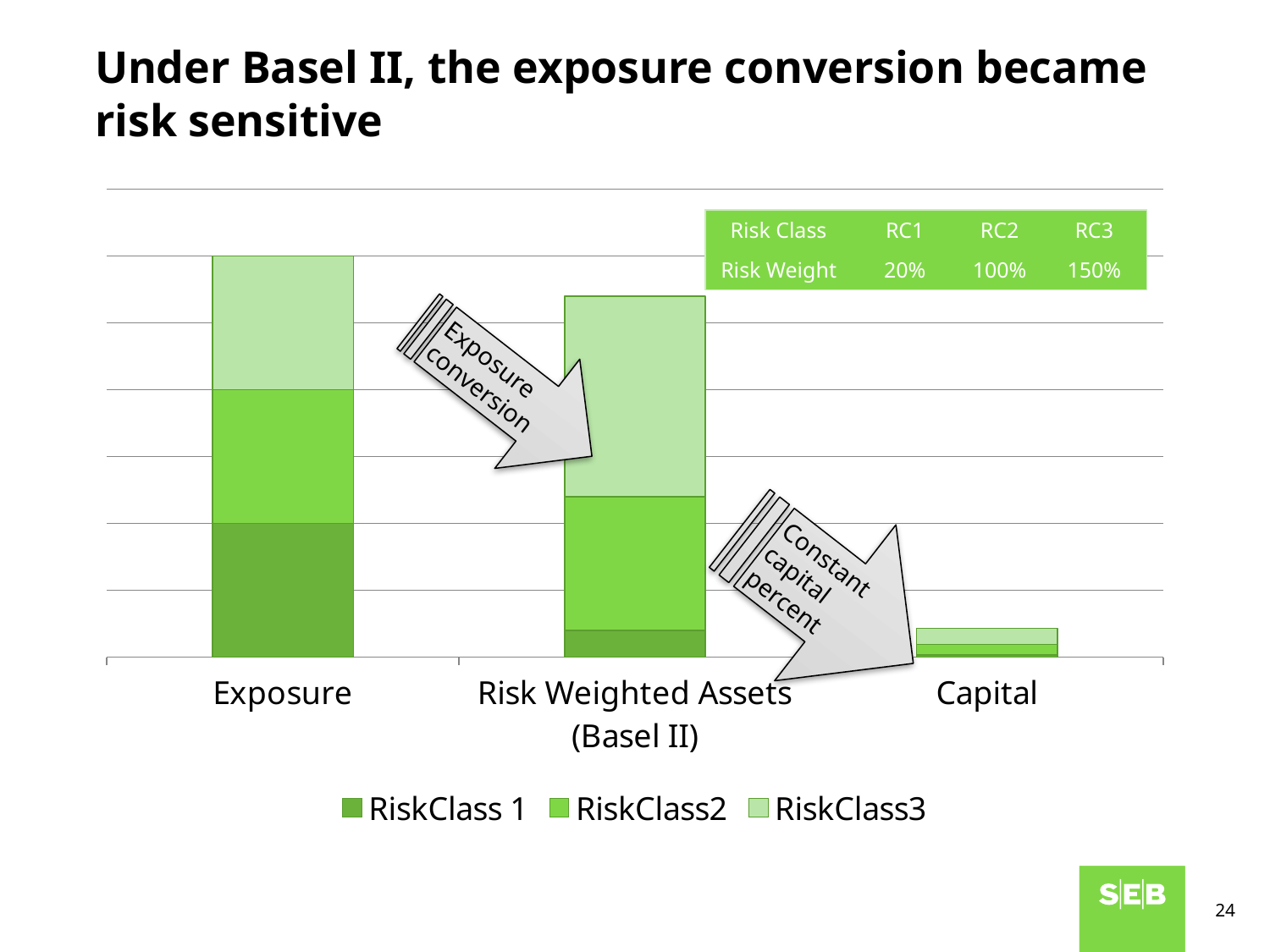
Which category has the tallest stacked bar? Exposure Is the RiskClass 1 segment larger in the Exposure bar or in the Risk Weighted Assets (Basel II) bar? Exposure What kind of chart is shown on the slide? Stacked bar chart Which category has the shortest stacked bar? Capital What is the label of the middle category on the x axis? Risk Weighted Assets (Basel II) Which stacked bar is taller, Exposure or Risk Weighted Assets (Basel II)? Exposure In the Risk Weighted Assets (Basel II) bar, which segment is larger, RiskClass 1 or RiskClass3? RiskClass3 Which series is shown in the darkest green in the legend? RiskClass 1 How many categories are shown on the x axis of the chart? 3 Do the total bar heights rise or fall moving from left to right along the x axis? Fall How many series does the chart legend list? 3